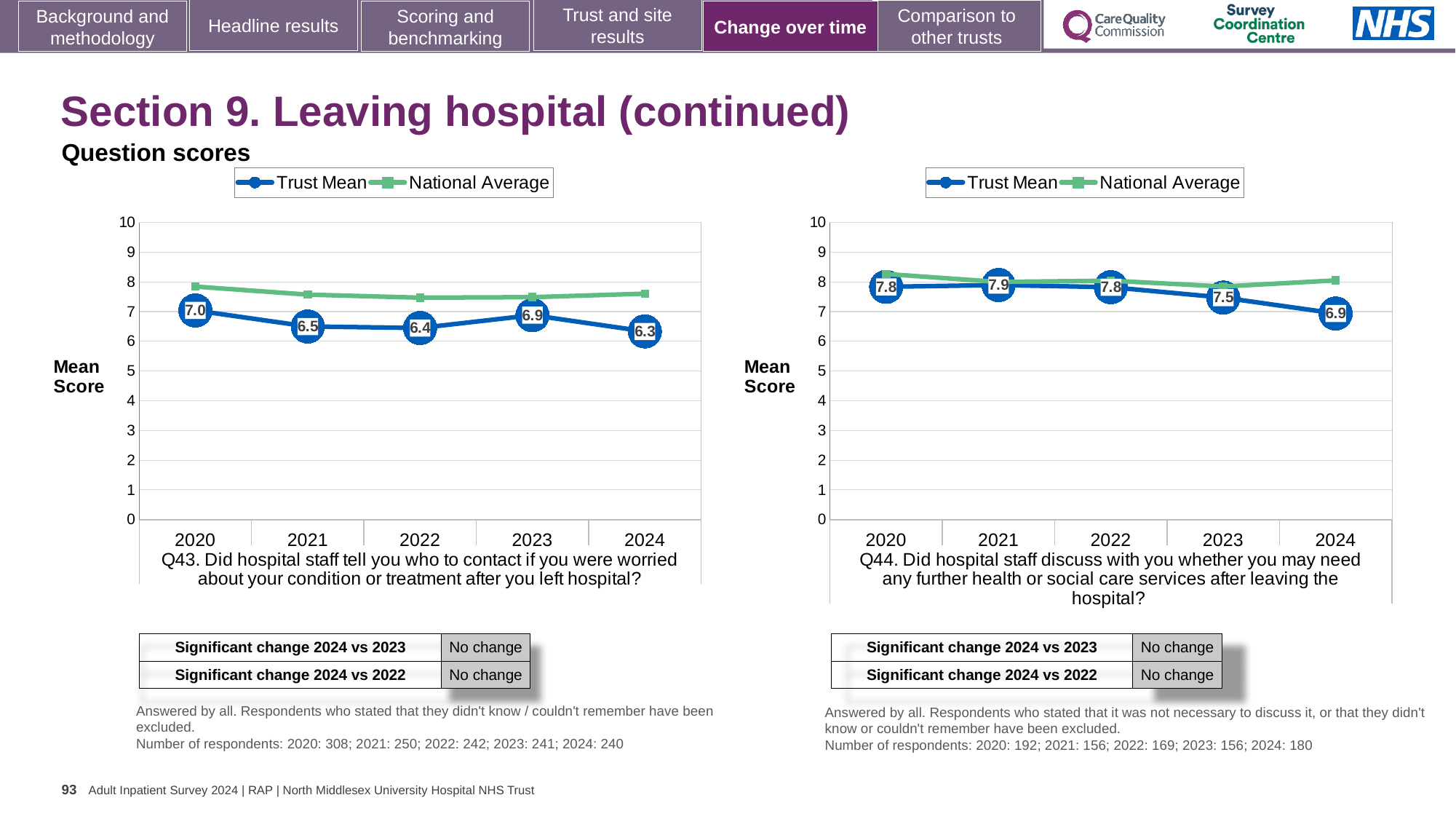
In the Q44 chart (right), which year has the lowest Trust Mean score? 2024 How many series does the legend of the Q44 chart (right) list? 2 In the Q44 chart (right), what is the Trust Mean score for 2021? 7.9 In the Q43 chart (left), what is the Trust Mean score for 2020? 7.0 What kind of chart is the Q43 chart (left)? Line chart In the Q44 chart (right), what is the Trust Mean score for 2023? 7.5 In the Q43 chart (left), which year has the highest Trust Mean score? 2020 In the Q43 chart (left), what is the difference between the Trust Mean scores for 2020 and 2024? 0.7 In the Q43 chart (left), what is the Trust Mean score for 2024? 6.3 In the Q43 chart (left), which year has the lowest Trust Mean score? 2024 In the Q43 chart (left), is the National Average for 2020 greater or less than 7? greater In the Q44 chart (right), is the Trust Mean score for 2022 larger than the Trust Mean score for 2024? Yes